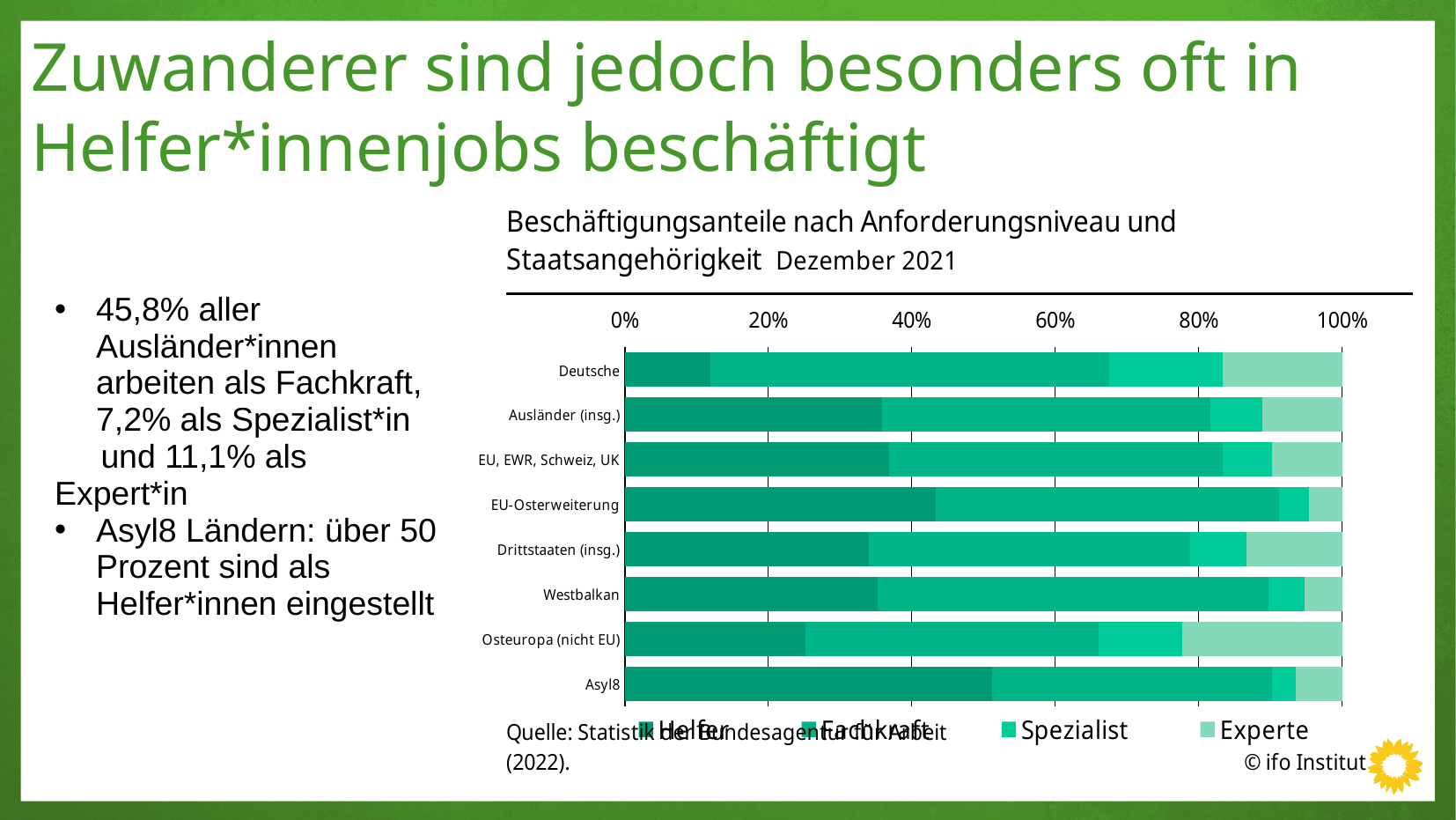
How many series does the chart legend list? 4 Which has the larger Experte share, Osteuropa (nicht EU) or EU-Osterweiterung? Osteuropa (nicht EU) Is the Helfer share for Deutsche greater or less than 20%? less Which category has the smallest Helfer share? Deutsche What kind of chart is shown on the slide? Stacked bar chart Is the Helfer share for Asyl8 greater or less than 40%? greater Which category has the largest Helfer share? Asyl8 Which series are listed in the chart legend? Helfer, Fachkraft, Spezialist, Experte Is the Helfer share for Osteuropa (nicht EU) greater or less than 20%? greater How many categories (nationality groups) are shown on the chart? 8 Which has the larger Helfer share, Deutsche or Ausländer (insg.)? Ausländer (insg.) What is the title of the chart? Beschäftigungsanteile nach Anforderungsniveau und Staatsangehörigkeit Dezember 2021